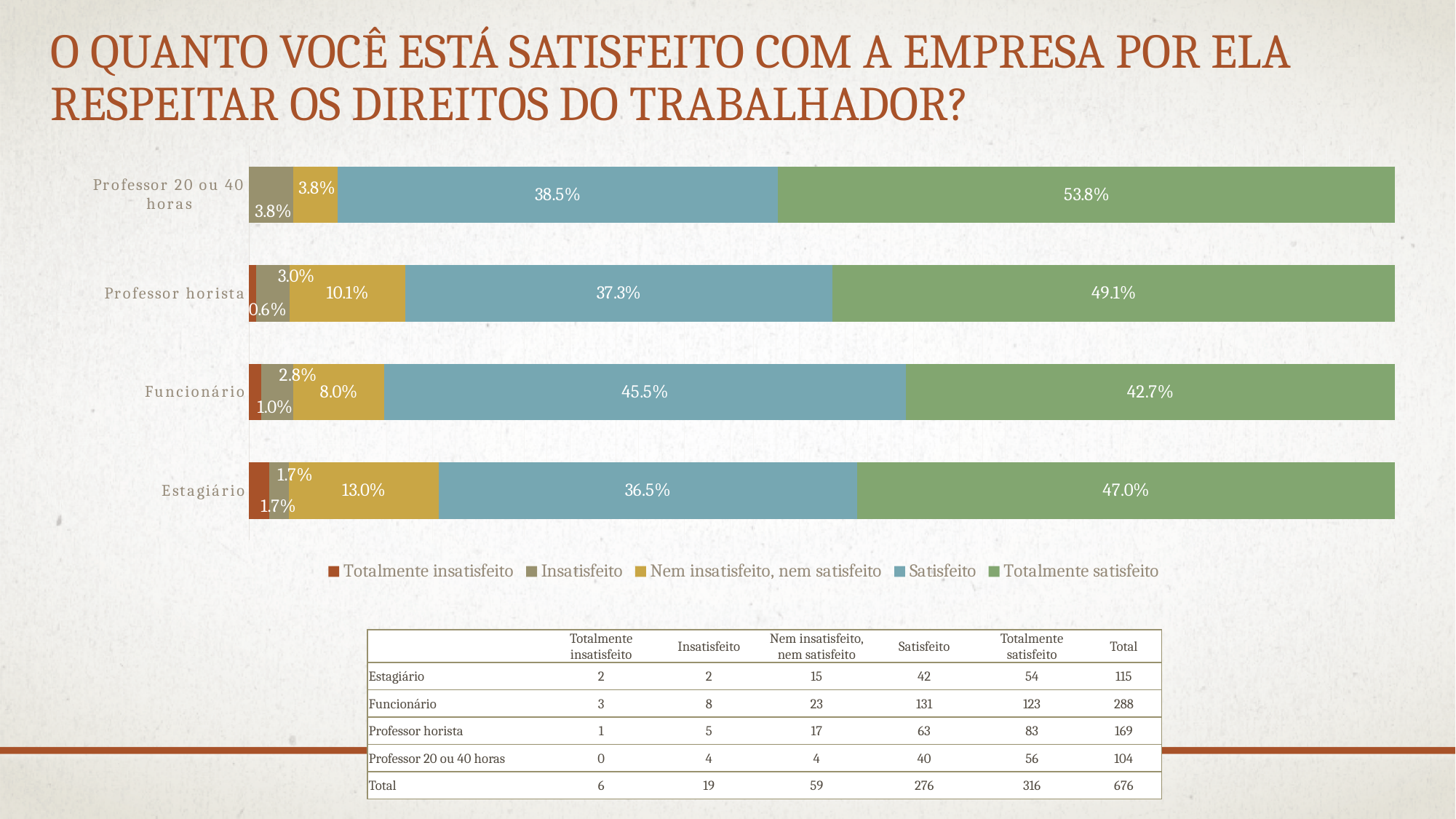
In the Funcionário bar, what is the difference between the Satisfeito value and the Totalmente satisfeito value? 2.8 percentage points What is the value for Nem insatisfeito, nem satisfeito in the Estagiário bar? 13.0% Which category has the highest Totalmente satisfeito value? Professor 20 ou 40 horas Which is larger: the Nem insatisfeito, nem satisfeito value for Professor horista or for Funcionário? Professor horista What is the value for Satisfeito in the Funcionário bar? 45.5% What colour represents Totalmente satisfeito in the legend? Green How many categories are shown in the chart? 4 How many series does the legend list? 5 What is the value for Totalmente insatisfeito in the Professor horista bar? 0.6% What is the value for Totalmente satisfeito in the Professor 20 ou 40 horas bar? 53.8% What kind of chart is shown on the slide? Stacked bar chart Which category has the lowest Satisfeito value? Estagiário